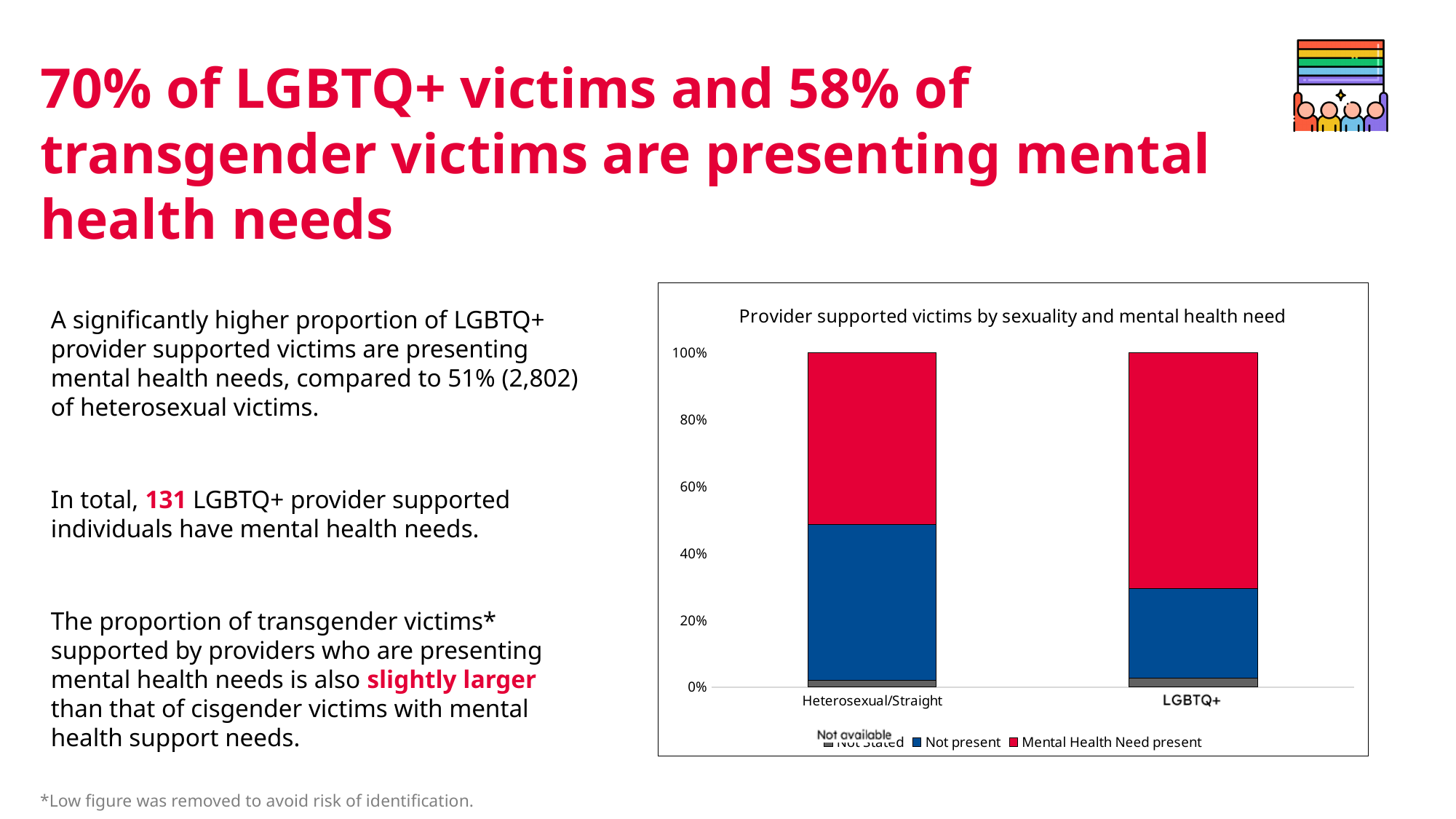
Is the top of the 'Not present' segment for Heterosexual/Straight greater or less than 40%? greater What is the title of the chart? Provider supported victims by sexuality and mental health need Which category has the larger 'Not present' segment, Heterosexual/Straight or LGBTQ+? Heterosexual/Straight Which colour represents 'Mental Health Need present' in the chart? Red Is the top of the 'Not present' segment for LGBTQ+ greater or less than 40%? less How many series does the chart's legend list? 3 What kind of chart is shown on the slide? Stacked bar chart Is the 'Mental Health Need present' share for LGBTQ+ greater or less than 60%? greater How many categories are shown on the x axis of the chart? 2 What is the highest value shown on the chart's y axis? 100% What is the total height of each stacked bar in the chart? 100% Which category has the larger 'Mental Health Need present' segment, Heterosexual/Straight or LGBTQ+? LGBTQ+